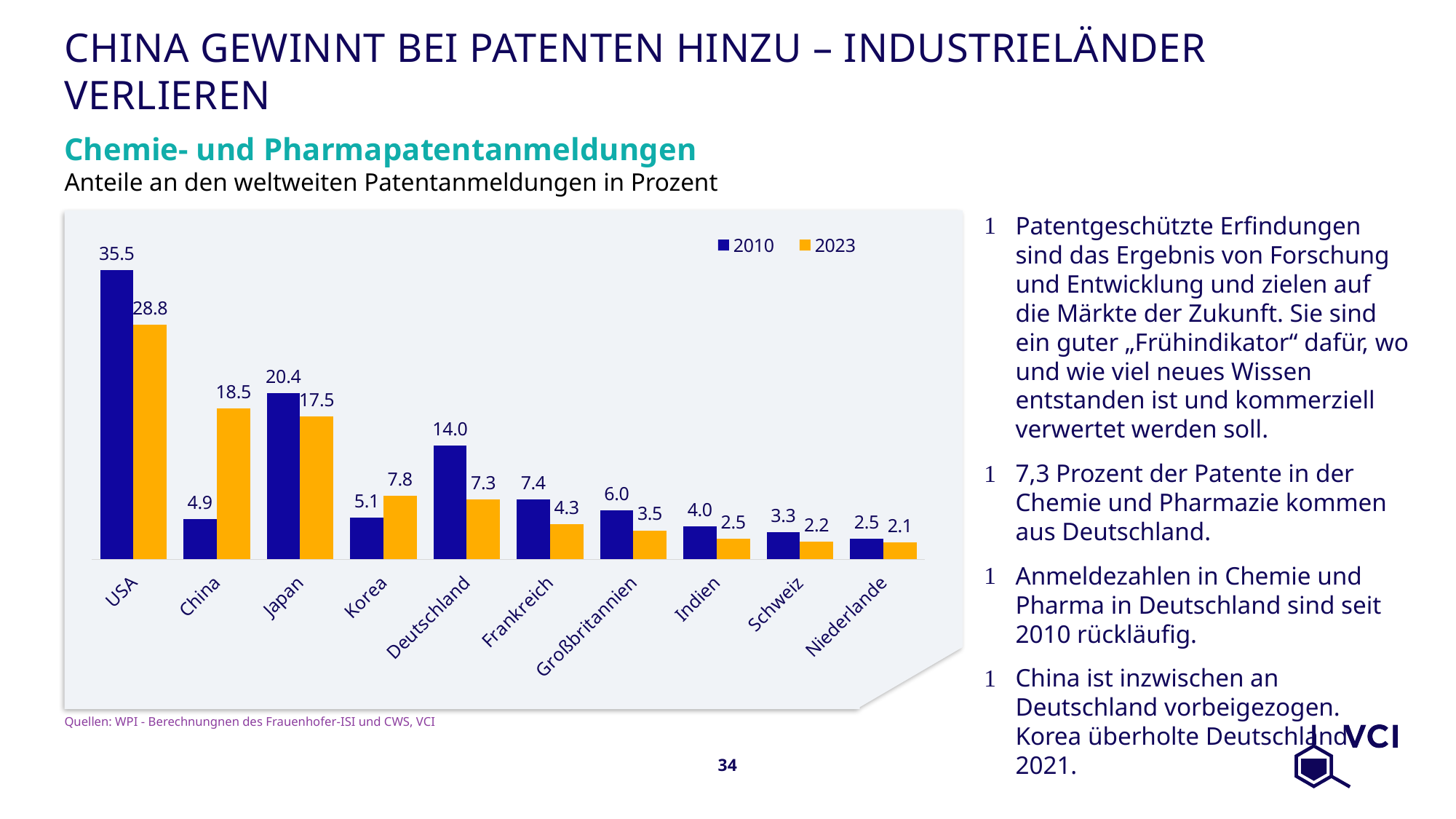
What is the title of the chart? Chemie- und Pharmapatentanmeldungen How many countries are shown on the x axis? 10 What is the difference between the 2010 and 2023 values for Deutschland? 6.7 What is the value for Deutschland in 2023? 7.3 Which country has the lowest value in 2010? Niederlande What kind of chart is shown on the slide? Bar chart Which country has the highest value in 2023? USA What is the value for USA in 2010? 35.5 Which country's value increased from 2010 to 2023? China and Korea How many series does the legend list? 2 What is the value for China in 2023? 18.5 Which is larger: the 2023 value for China or the 2023 value for Japan? China